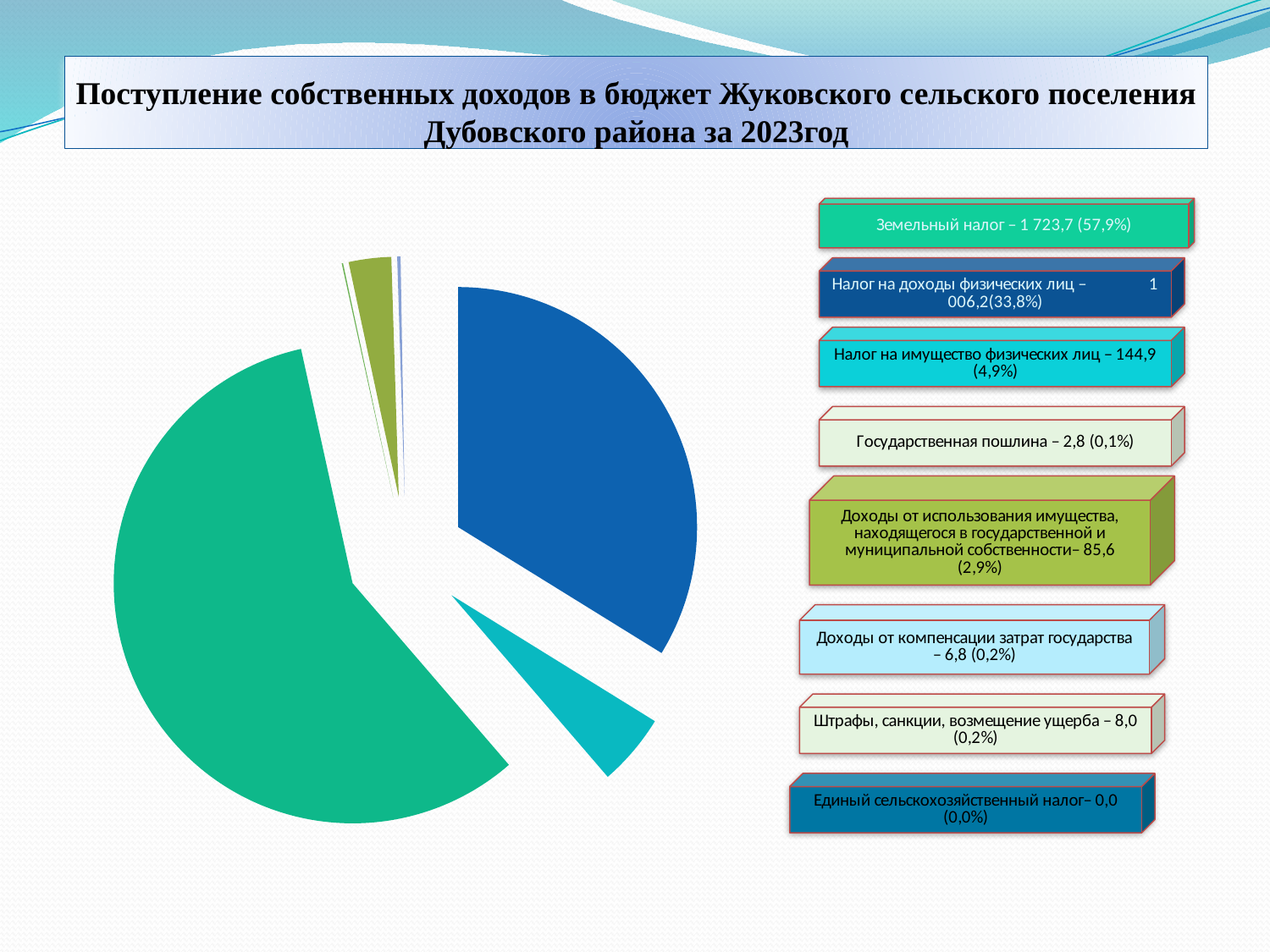
What kind of chart is shown on the slide? pie chart Which category has the largest share of the pie? Земельный налог What is the value shown for Земельный налог? 1 723,7 What is the value shown for Налог на имущество физических лиц? 144,9 How many revenue categories are listed in the legend of the chart? 8 Which is larger: the value for Штрафы, санкции, возмещение ущерба or the value for Доходы от компенсации затрат государства? Штрафы, санкции, возмещение ущерба What share of the pie does Налог на доходы физических лиц account for? 33,8% What is the difference between the values for Земельный налог and Налог на доходы физических лиц? 717,5 What share of the pie does Доходы от использования имущества, находящегося в государственной и муниципальной собственности account for? 2,9% Which category has the smallest value? Единый сельскохозяйственный налог What share of the pie does Земельный налог account for? 57,9% What is the value shown for Государственная пошлина? 2,8